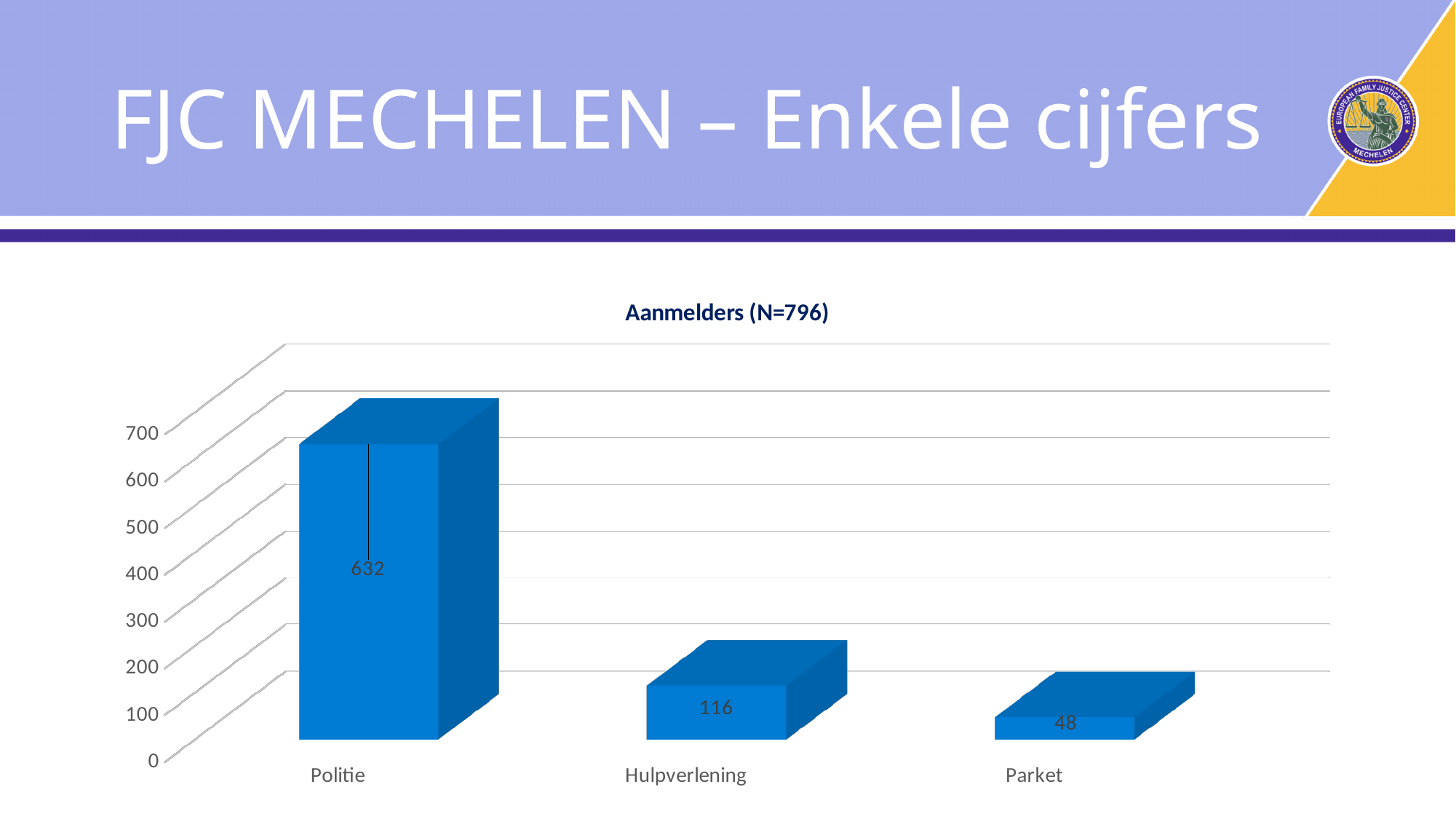
What is the value for Politie? 632 Which is larger, the value for Hulpverlening or the value for Parket? Hulpverlening What kind of chart is shown on the slide? bar chart Which category has the highest value? Politie What is the title of the chart? Aanmelders (N=796) What is the value for Parket? 48 Which category has the lowest value? Parket How many categories are shown in the chart? 3 Is the value for Politie greater or less than 500? greater What is the difference between the values for Hulpverlening and Parket? 68 What is the value for Hulpverlening? 116 What is the difference between the values for Politie and Hulpverlening? 516